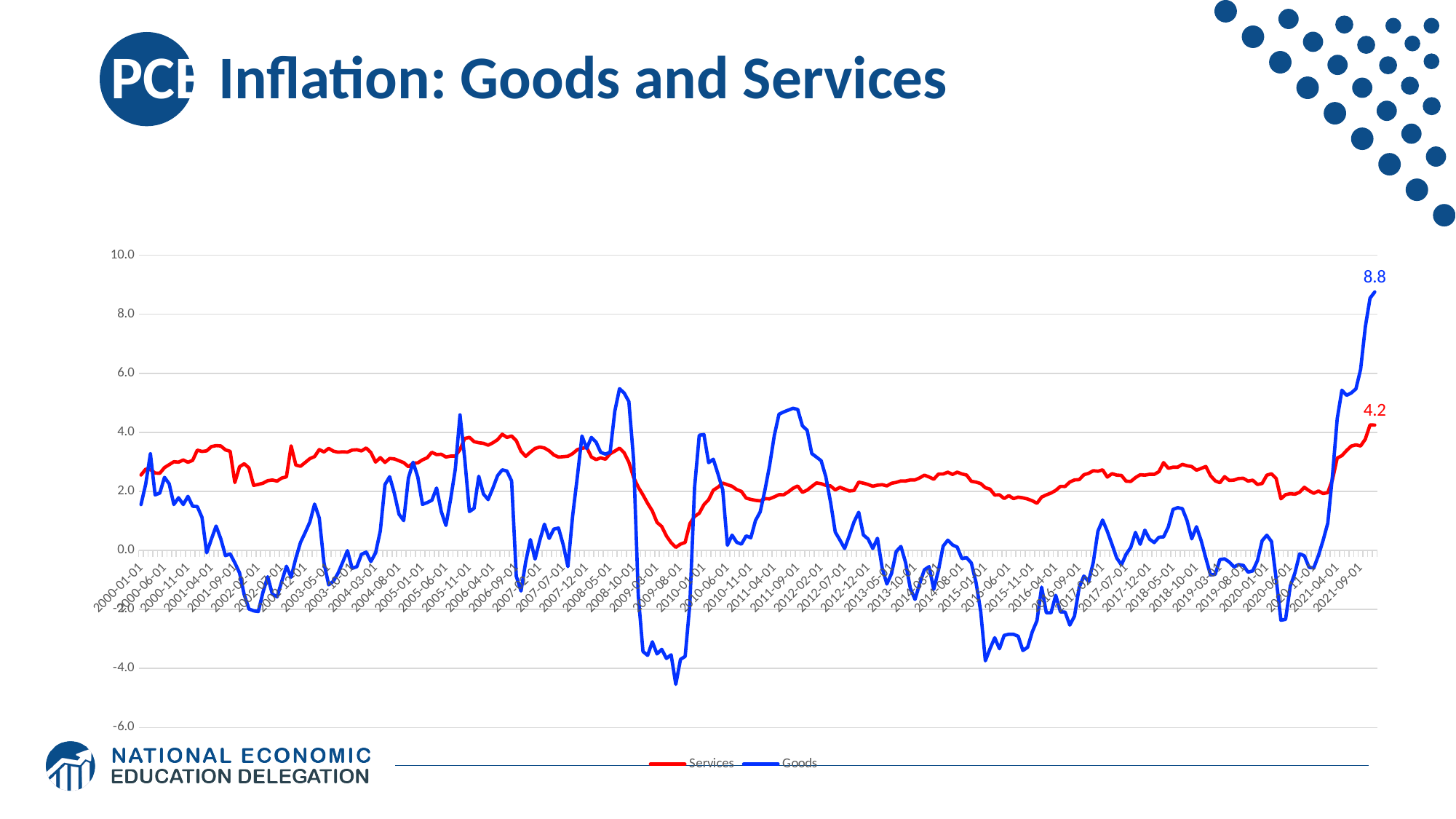
Is the value of the Goods series around 2015-06-01 greater or less than -2.0? less What is the difference between the labelled final values of Goods (8.8) and Services (4.2)? 4.6 Is the value of the Services series around 2009-08-01 greater or less than 2.0? less At the end of the chart, which series has the higher value, Goods or Services? Goods What is the labelled final value of the Services series? 4.2 What colour is the Goods line? blue How many series does the legend list? 2 What type of chart is shown on the slide? line chart Which series reaches the highest value anywhere on the chart? Goods What is the labelled final value of the Goods series? 8.8 Is the value of the Goods series around 2009-08-01 greater or less than -2.0? less Does the Goods series rise or fall between 2020-06-01 and 2021-09-01? rise